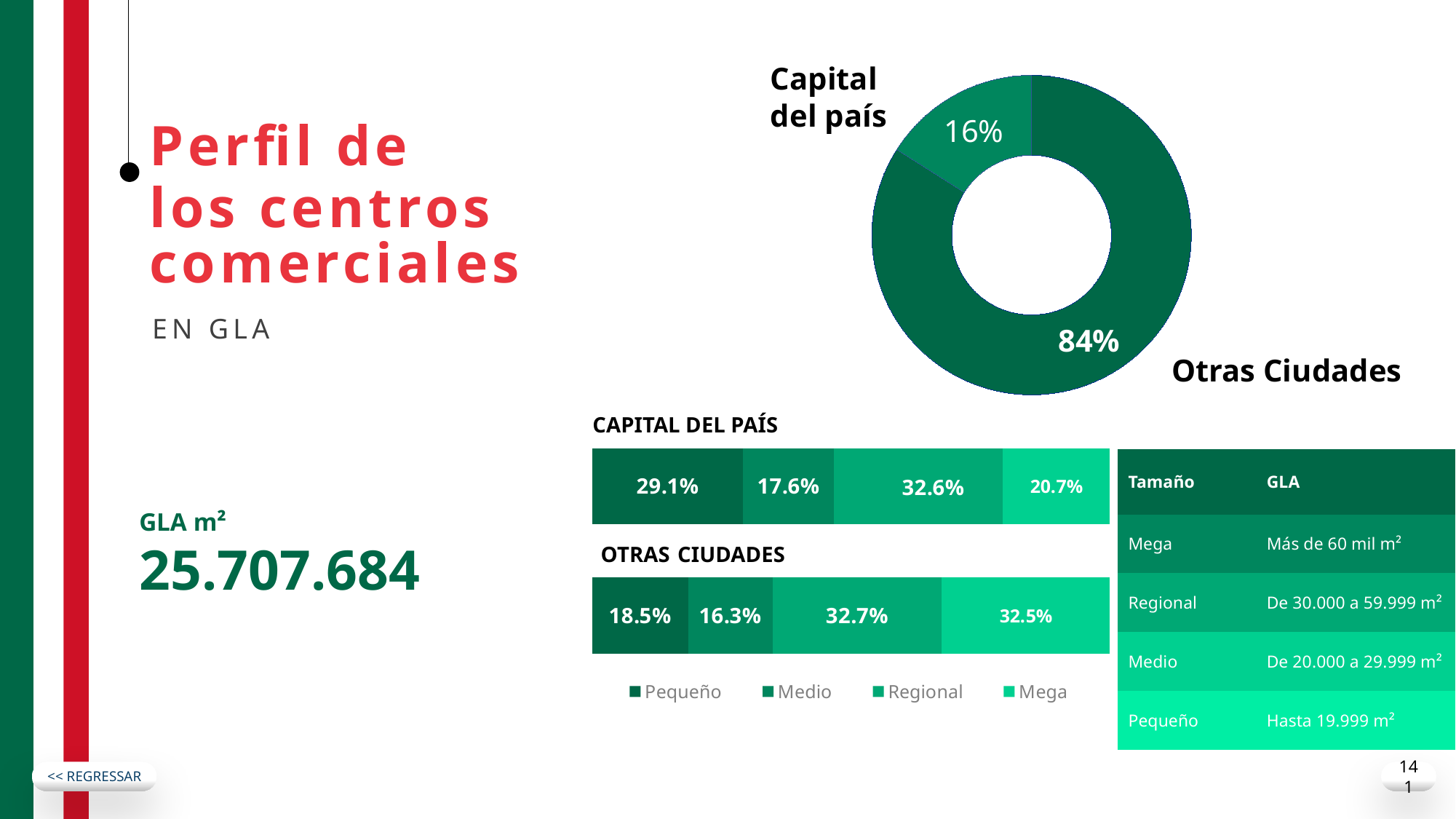
What kind of chart is the chart at the top right of the slide? Donut chart In the donut chart, what share does Capital del país have? 16% In the donut chart, what share does Otras Ciudades have? 84% In the CAPITAL DEL PAÍS stacked bar, what is the value for Regional? 32.6% How many series does the legend below the stacked bars list? 4 In the donut chart, which segment is larger, Capital del país or Otras Ciudades? Otras Ciudades In the CAPITAL DEL PAÍS stacked bar, which segment is the largest? Regional In the OTRAS CIUDADES stacked bar, what is the value for Mega? 32.5% In the OTRAS CIUDADES stacked bar, which segment is the smallest? Medio In the donut chart, what is the difference between the Otras Ciudades share and the Capital del país share? 68% What is the difference between the Mega value in the OTRAS CIUDADES bar and the Mega value in the CAPITAL DEL PAÍS bar? 11.8% In the CAPITAL DEL PAÍS stacked bar, what is the value for Pequeño? 29.1%